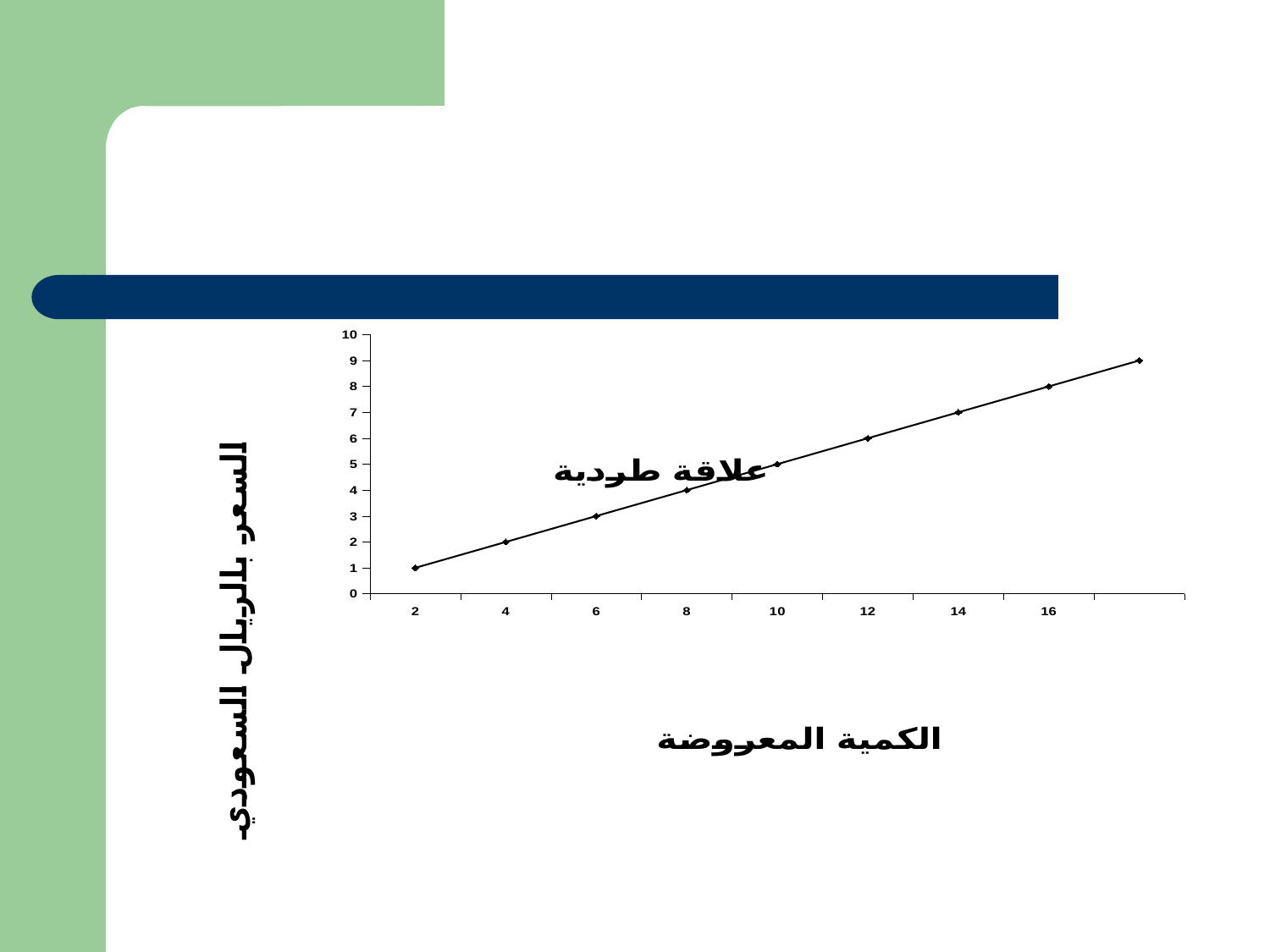
What text label is written on the chart next to the line? علاقة طردية What is the y value at x = 2? 1 What is the y value at x = 16? 8 What kind of chart is shown on the slide? line chart Is the y value at x = 10 greater or less than 8? less Do the plotted values rise or fall as the x-axis value increases? rise Which has the larger y value, x = 6 or x = 14? x = 14 What is the difference between the y values at x = 16 and x = 4? 6 What is the y value at x = 12? 6 At which x value is the plotted y value lowest? 2 What is the y value at x = 8? 4 How many data points are plotted on the line? 9